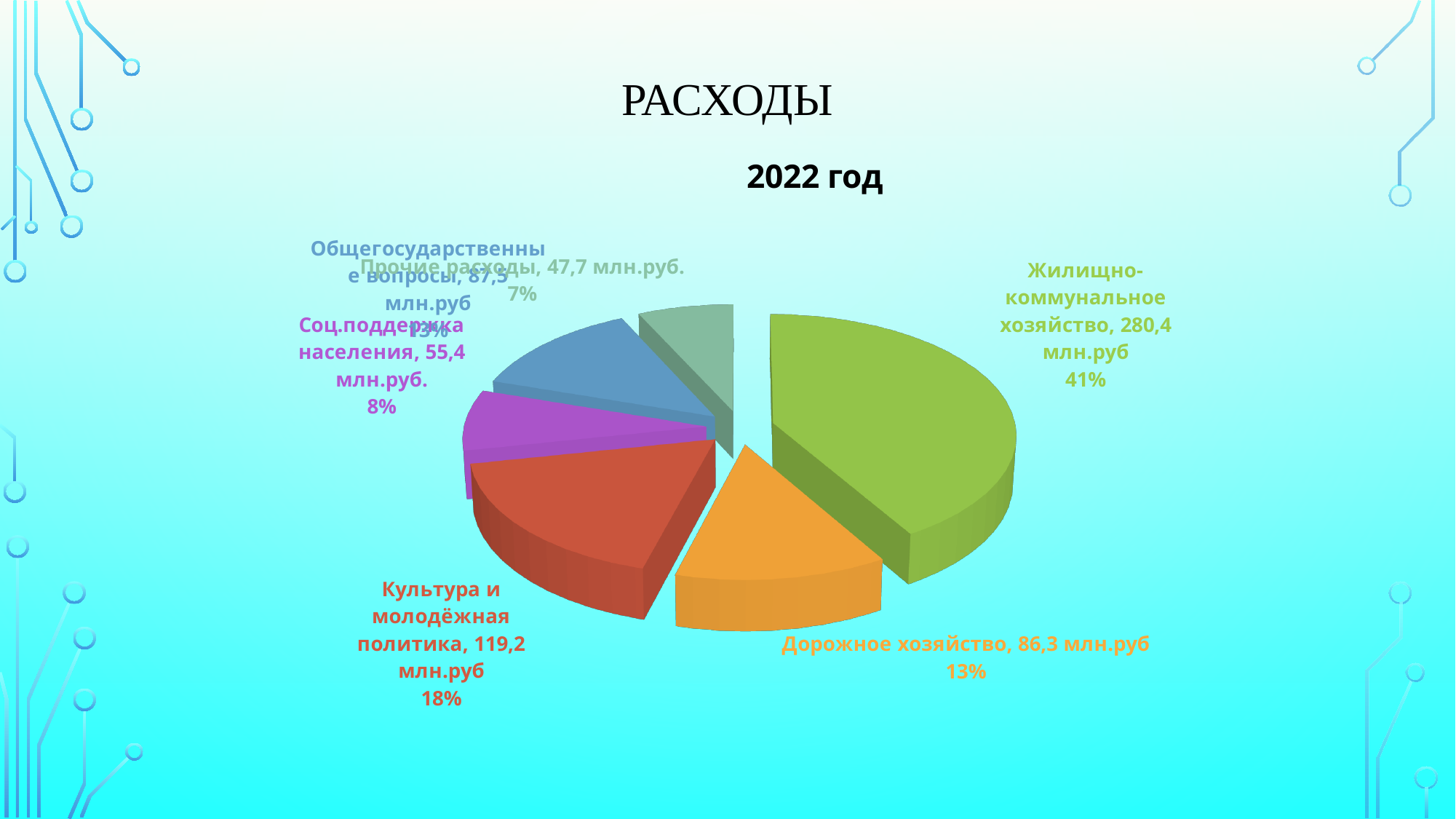
What share of the pie does Жилищно-коммунальное хозяйство take? 41% What is the value for Дорожное хозяйство? 86,3 млн.руб Which category has the smallest slice of the pie? Прочие расходы How many slices does the pie chart have? 6 What share of the pie does Культура и молодёжная политика take? 18% Which is larger: Соц.поддержка населения or Прочие расходы? Соц.поддержка населения What is the value for Жилищно-коммунальное хозяйство? 280,4 млн.руб Which category has the largest slice of the pie? Жилищно-коммунальное хозяйство What kind of chart is shown on the slide? pie chart What is the difference between the values for Культура и молодёжная политика and Дорожное хозяйство? 32,9 млн.руб What is the value for Соц.поддержка населения? 55,4 млн.руб. What is the title of the pie chart? 2022 год